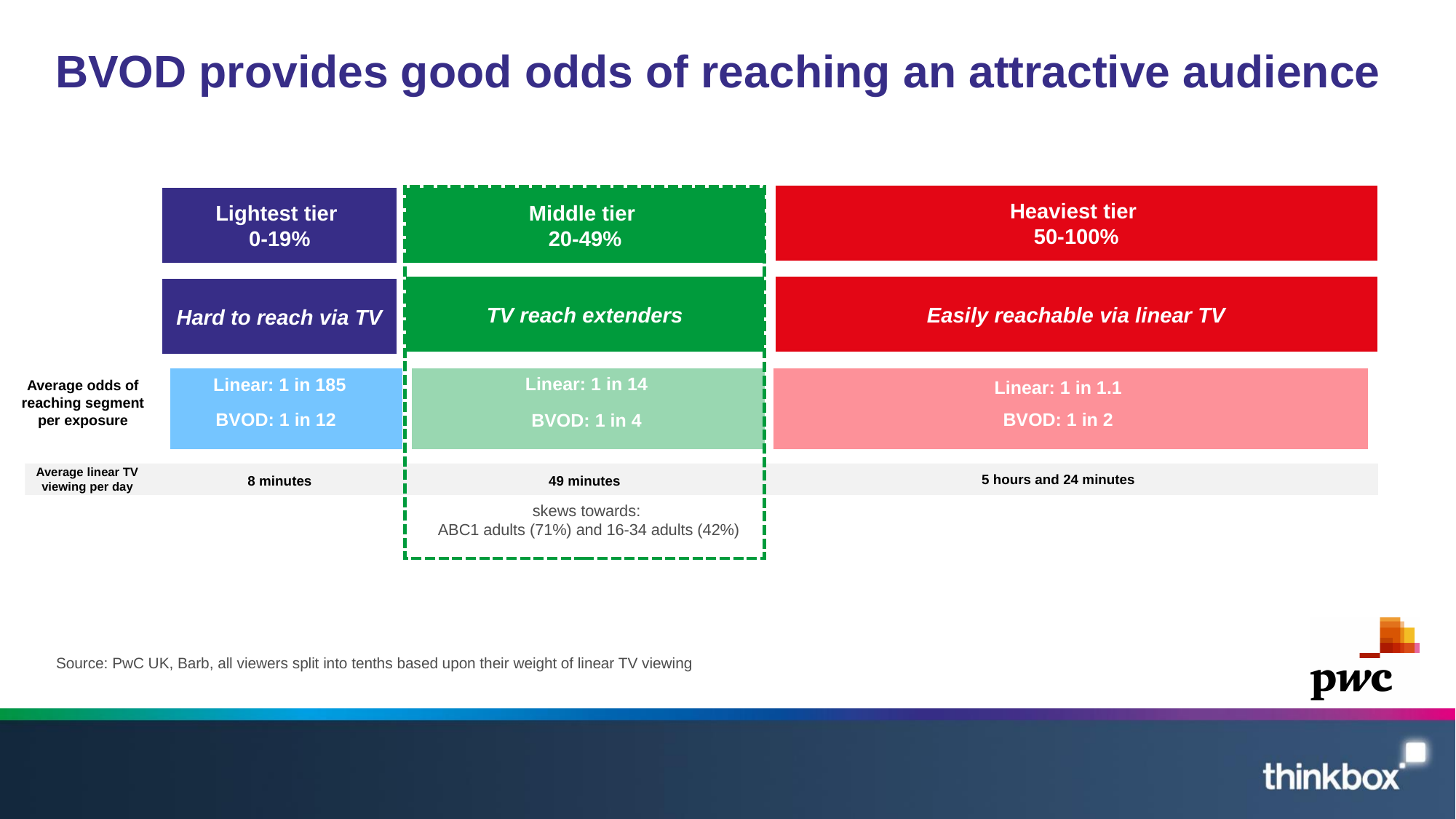
What is the average linear TV viewing per day for the middle tier? 49 minutes What label describes the heaviest tier's reachability? Easily reachable via linear TV What are the average odds of reaching the lightest tier per exposure via BVOD? 1 in 12 What are the average odds of reaching the middle tier per exposure via BVOD? 1 in 4 How many viewing tiers are shown on the slide? 3 Which tier has the lowest average linear TV viewing per day? Lightest tier What is the average linear TV viewing per day for the heaviest tier? 5 hours and 24 minutes What are the average odds of reaching the heaviest tier per exposure via BVOD? 1 in 2 What are the average odds of reaching the middle tier per exposure via linear TV? 1 in 14 What is the average linear TV viewing per day for the lightest tier? 8 minutes What are the average odds of reaching the lightest tier per exposure via linear TV? 1 in 185 What percentage range of linear TV viewing weight defines the middle tier? 20-49%